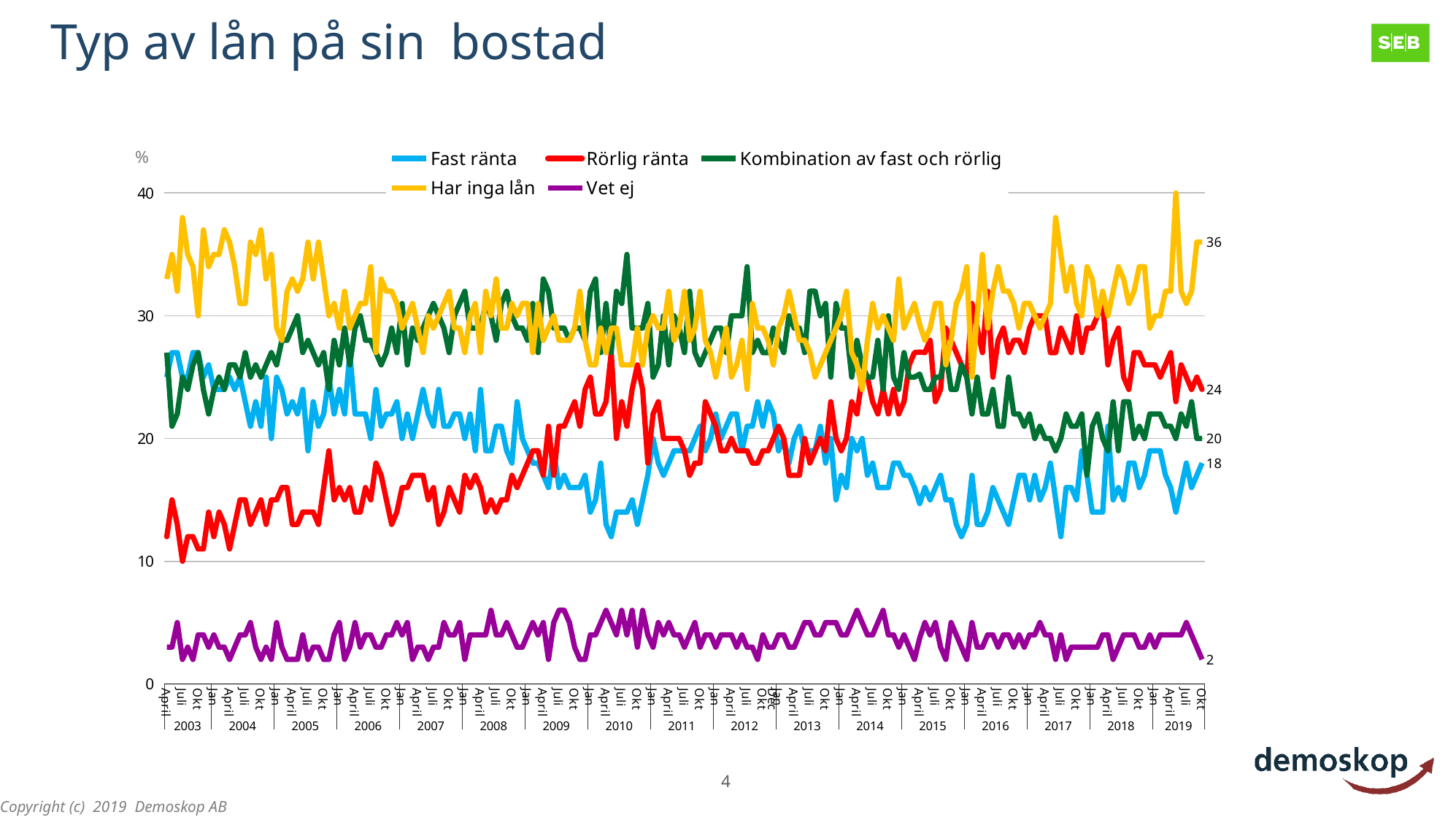
What is the final (Okt 2019) value for Rörlig ränta? 24 What is the final (Okt 2019) value for Kombination av fast och rörlig? 20 What is the final (Okt 2019) value for Har inga lån? 36 What is the final (Okt 2019) value for Fast ränta? 18 Which series has the lowest value at the end of the chart (Okt 2019)? Vet ej At the end of the chart, which is larger: Rörlig ränta or Fast ränta? Rörlig ränta What is the final (Okt 2019) value for Vet ej? 2 Does the Fast ränta series generally rise or fall from 2003 to 2019? fall Which series has the highest value at the end of the chart (Okt 2019)? Har inga lån How many series does the legend list? 5 What is the difference between the final values of Har inga lån and Rörlig ränta? 12 What kind of chart is shown on the slide? line chart